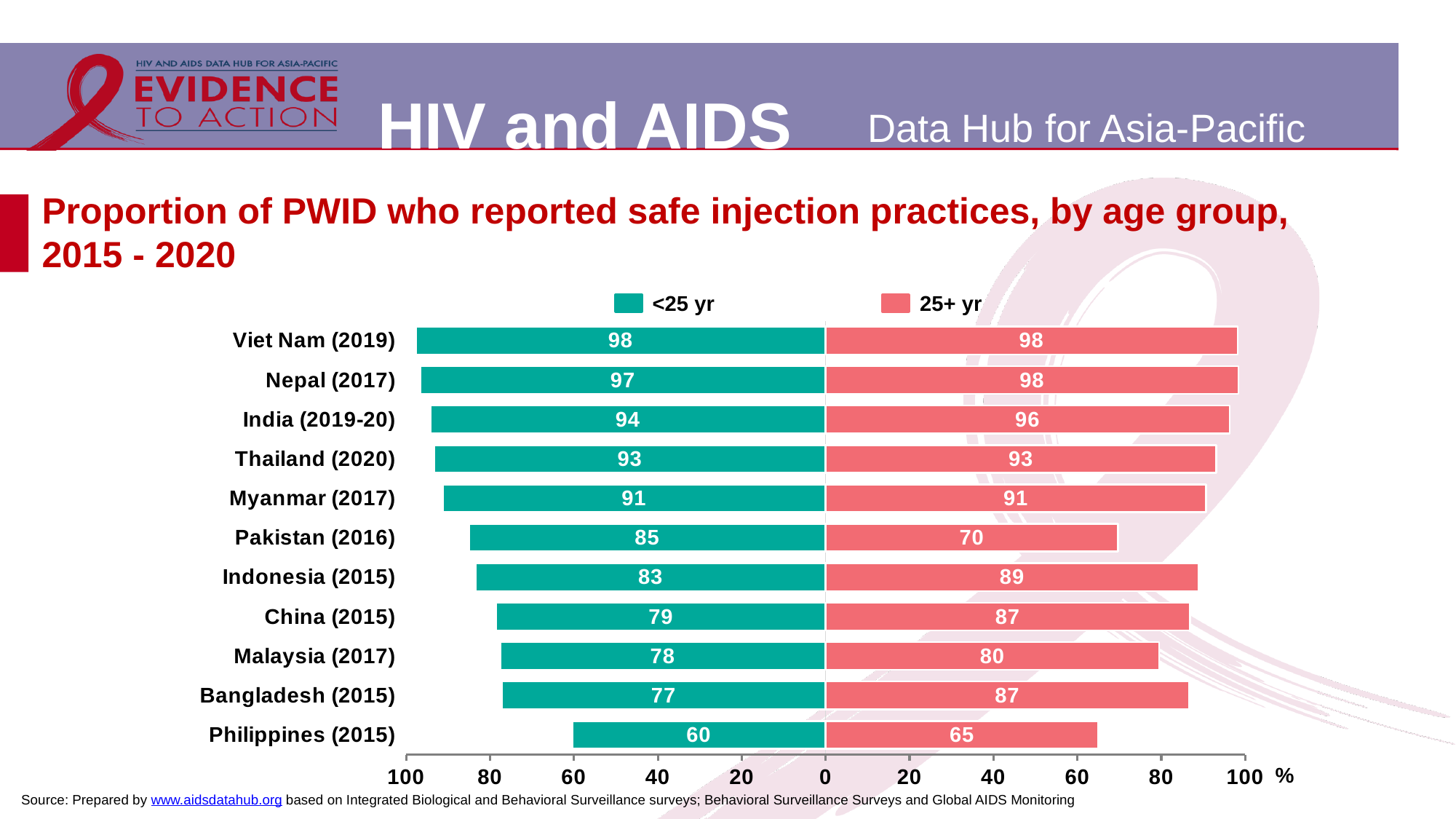
For China (2015), which age group has the larger value, <25 yr or 25+ yr? 25+ yr What is the value for Pakistan (2016) in the <25 yr series? 85 What is the difference between the 25+ yr and <25 yr values for Bangladesh (2015)? 10 What kind of chart is shown on the slide? Bar chart How many countries are shown in the chart? 11 Which country has the highest value in the <25 yr series? Viet Nam (2019) What is the value for Bangladesh (2015) in the 25+ yr series? 87 What is the difference between the 25+ yr and <25 yr values for Pakistan (2016)? 15 How many series does the legend list? 2 For Pakistan (2016), which age group has the larger value, <25 yr or 25+ yr? <25 yr What is the value for Philippines (2015) in the <25 yr series? 60 Which country has the lowest value in the 25+ yr series? Philippines (2015)